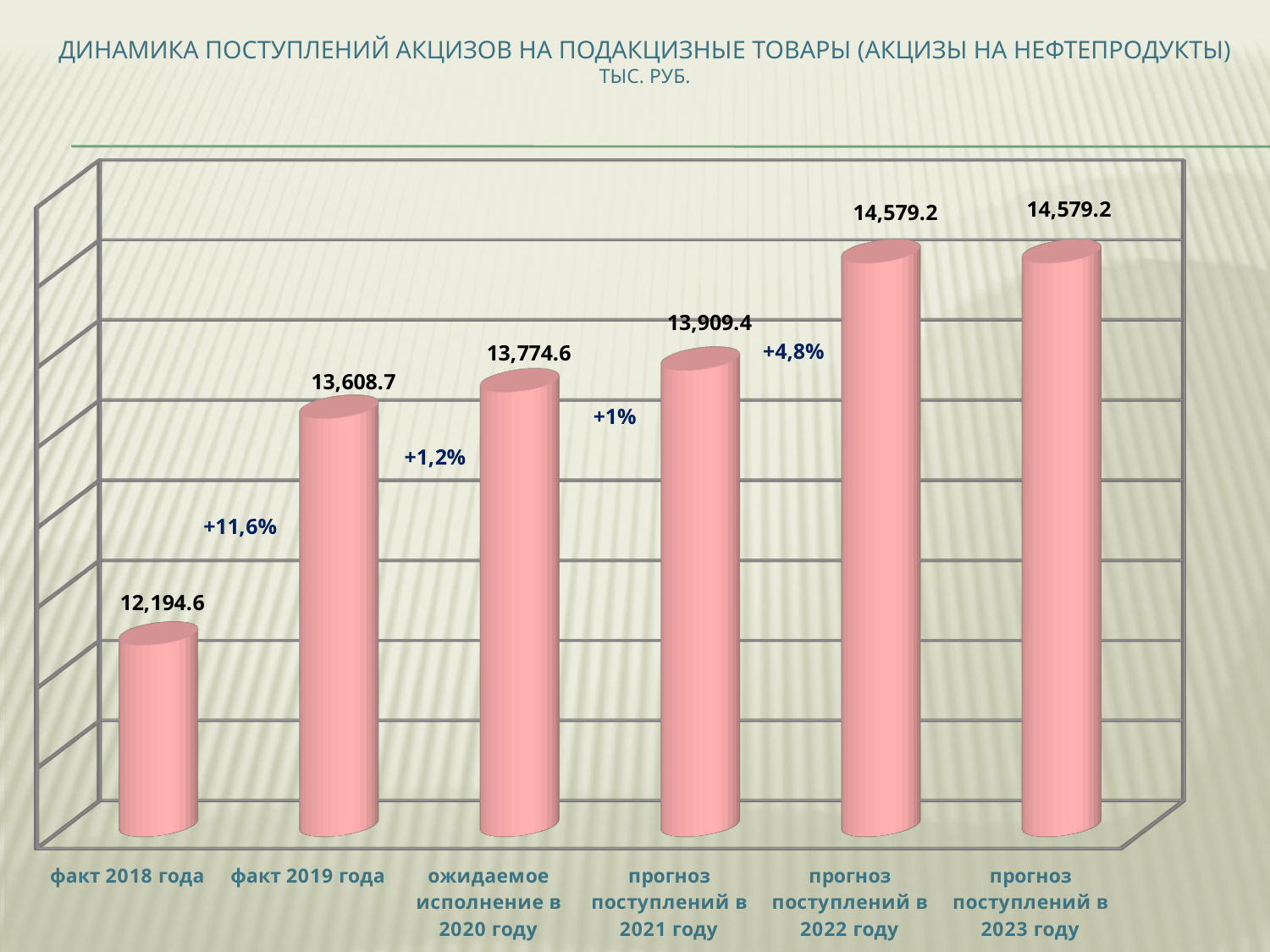
What percentage change is annotated between факт 2018 года and факт 2019 года? +11,6% What is the difference between the values for факт 2019 года and факт 2018 года? 1,414.1 What is the value for ожидаемое исполнение в 2020 году? 13,774.6 Do the values generally rise or fall from left to right along the x axis? rise What is the value for прогноз поступлений в 2021 году? 13,909.4 What is the value for факт 2018 года? 12,194.6 What is the difference between the values for прогноз поступлений в 2022 году and прогноз поступлений в 2021 году? 669.8 How many categories are shown on the x axis? 6 Which is larger, the value for факт 2019 года or the value for ожидаемое исполнение в 2020 году? ожидаемое исполнение в 2020 году Which category has the lowest value? факт 2018 года What kind of chart is shown on the slide? bar chart What is the value for прогноз поступлений в 2023 году? 14,579.2